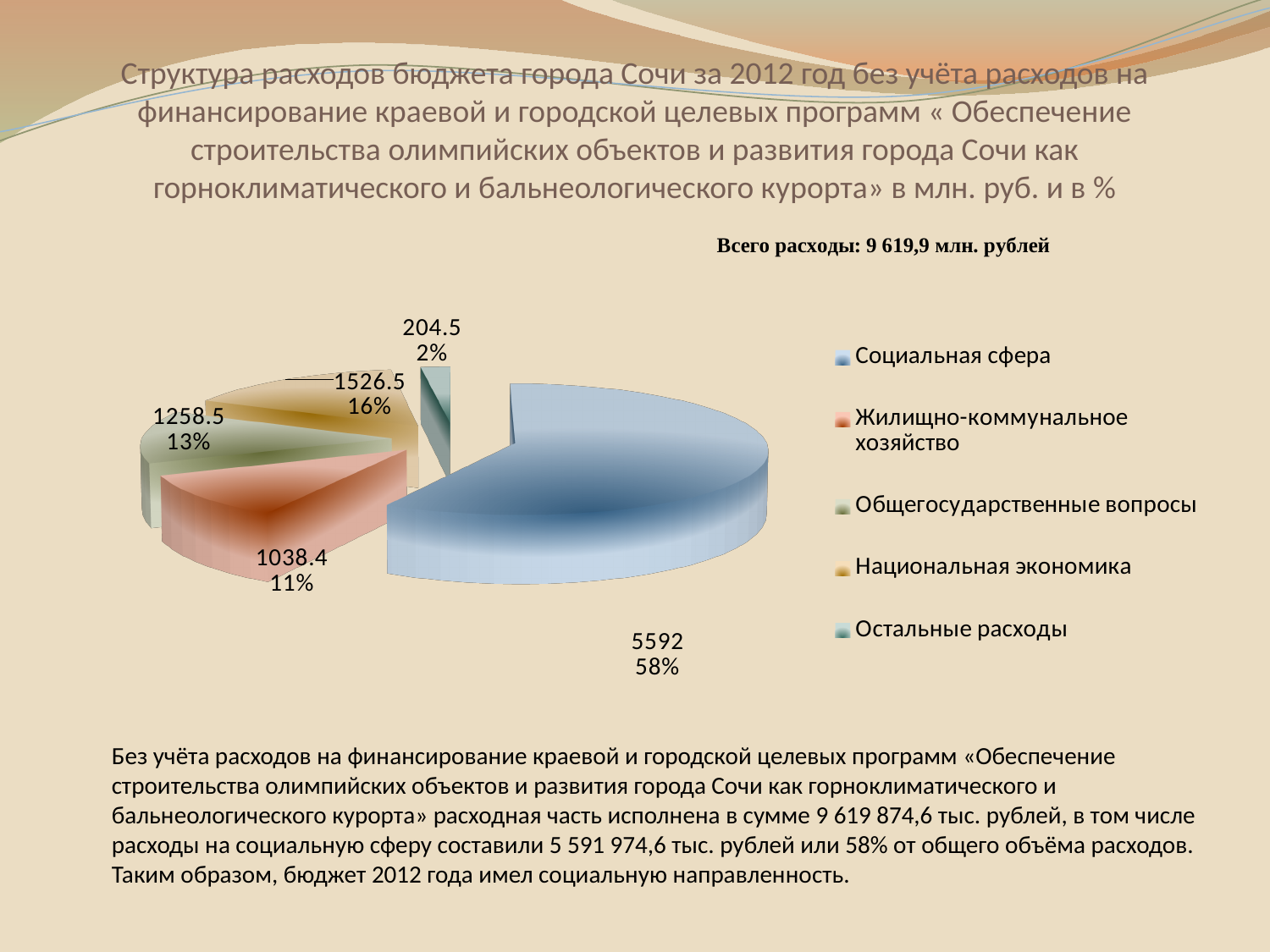
What total expenditure is stated above the chart? 9 619,9 млн. рублей What share of the pie does Социальная сфера take? 58% What value is shown for Национальная экономика? 1526.5 What is the difference between the values for Национальная экономика and Общегосударственные вопросы? 268 What value is shown for Социальная сфера? 5592 What value is shown for Жилищно-коммунальное хозяйство? 1038.4 What kind of chart is shown on the slide? pie chart How many slices does the pie chart have? 5 What share of the pie does Остальные расходы take? 2% Which category has the largest slice? Социальная сфера Which category has the smallest slice? Остальные расходы Which is larger, Общегосударственные вопросы or Национальная экономика? Национальная экономика